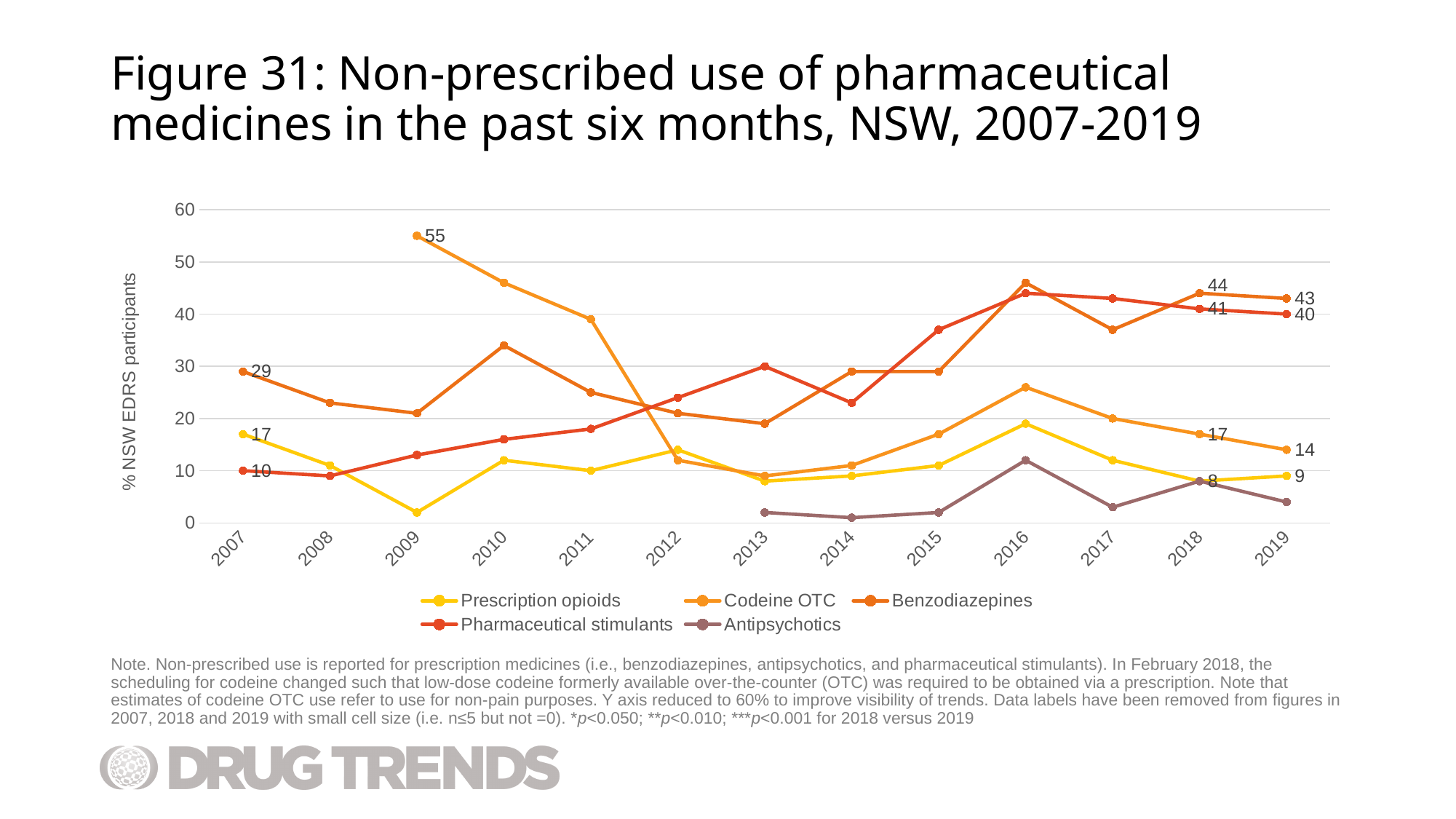
How many series does the legend list? 5 What was the value for Benzodiazepines in 2007? 29 What was the value for Prescription opioids in 2007? 17 What was the value for Pharmaceutical stimulants in 2019? 40 Is the value for Codeine OTC in 2010 greater or less than 40? greater What was the value for Codeine OTC in 2009? 55 What type of chart is shown on the slide? Line chart How many years are shown on the x axis? 13 What is the difference between the Codeine OTC values in 2018 and 2019? 3 By how much did the Benzodiazepines value change from 2018 to 2019? 1 Which series reaches the highest point on the chart? Codeine OTC In 2019, which was higher: Benzodiazepines or Pharmaceutical stimulants? Benzodiazepines